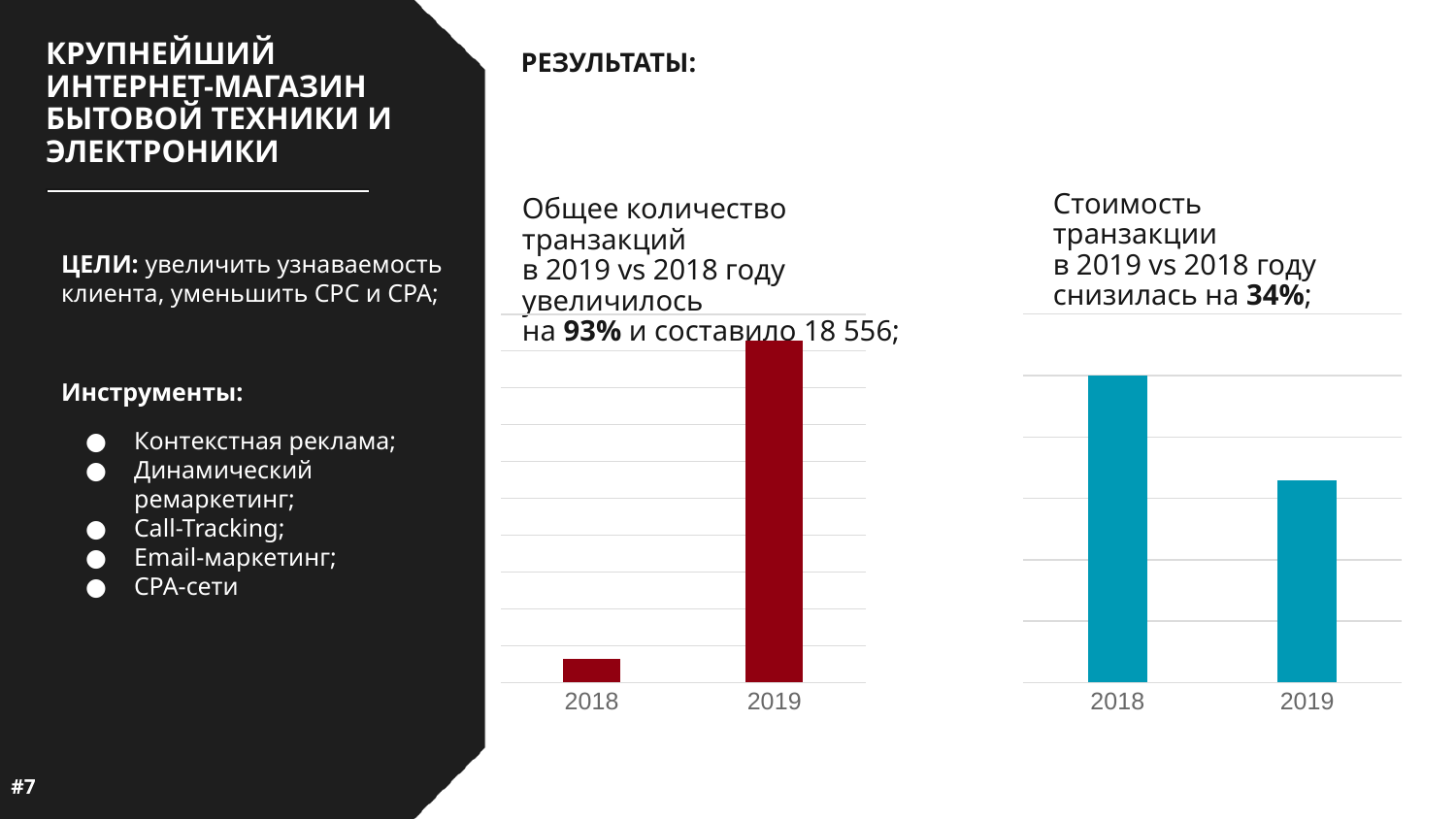
In the right chart (transaction cost), which year has the higher bar? 2018 What kind of chart is the right chart (transaction cost, 2018 vs 2019)? bar chart How many categories are shown on the x axis of the right chart (transaction cost)? 2 What colour are the bars in the right chart (transaction cost)? teal (blue) In the left chart (total number of transactions), which year has the lower bar? 2018 In the right chart (transaction cost), do the values rise or fall from 2018 to 2019? fall How many categories are shown on the x axis of the left chart (total number of transactions)? 2 In the left chart (total number of transactions), is the bar for 2019 larger or smaller than the bar for 2018? larger In the left chart (total number of transactions), which year has the higher bar? 2019 In the left chart (total number of transactions), do the values rise or fall from 2018 to 2019? rise What kind of chart is the left chart (total number of transactions, 2018 vs 2019)? bar chart In the right chart (transaction cost), which year has the lower bar? 2019